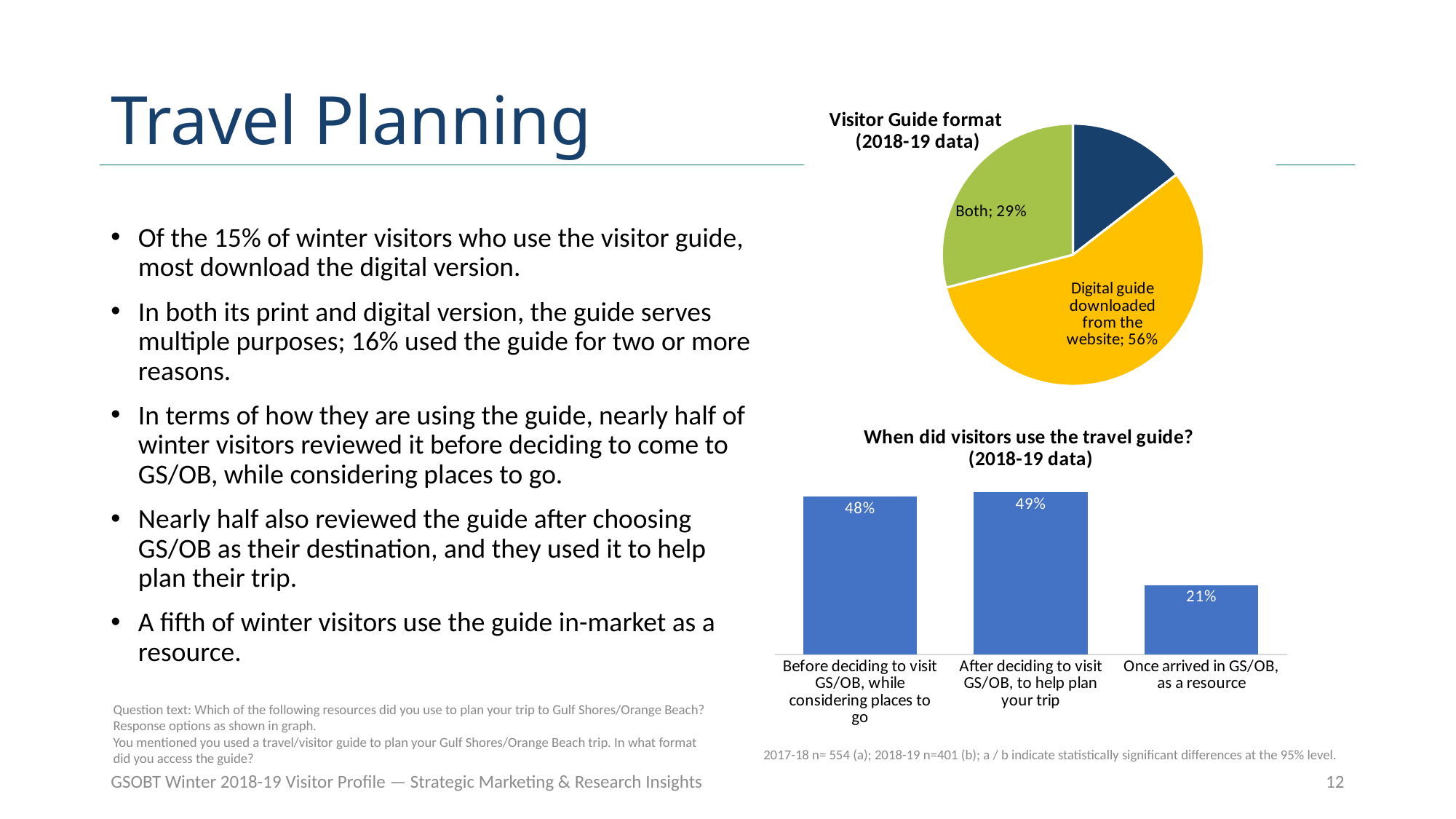
In the 'When did visitors use the travel guide?' chart, which category has the lowest value? Once arrived in GS/OB, as a resource What kind of chart is 'Visitor Guide format (2018-19 data)'? pie chart In the 'Visitor Guide format' chart, what share of the pie is 'Both'? 29% In the 'Visitor Guide format' chart, what share of the pie is 'Digital guide downloaded from the website'? 56% In the 'When did visitors use the travel guide?' chart, what is the value for 'Before deciding to visit GS/OB, while considering places to go'? 48% How many categories are shown in the 'When did visitors use the travel guide?' chart? 3 In the 'When did visitors use the travel guide?' chart, which is larger: 'Before deciding to visit GS/OB, while considering places to go' or 'Once arrived in GS/OB, as a resource'? Before deciding to visit GS/OB, while considering places to go In the 'Visitor Guide format' chart, what colour is the 'Digital guide downloaded from the website' slice? yellow In the 'When did visitors use the travel guide?' chart, what is the value for 'Once arrived in GS/OB, as a resource'? 21% In the 'When did visitors use the travel guide?' chart, what is the difference between the 'After deciding to visit GS/OB, to help plan your trip' value and the 'Once arrived in GS/OB, as a resource' value? 28% What kind of chart is 'When did visitors use the travel guide?'? bar chart In the 'When did visitors use the travel guide?' chart, what is the value for 'After deciding to visit GS/OB, to help plan your trip'? 49%